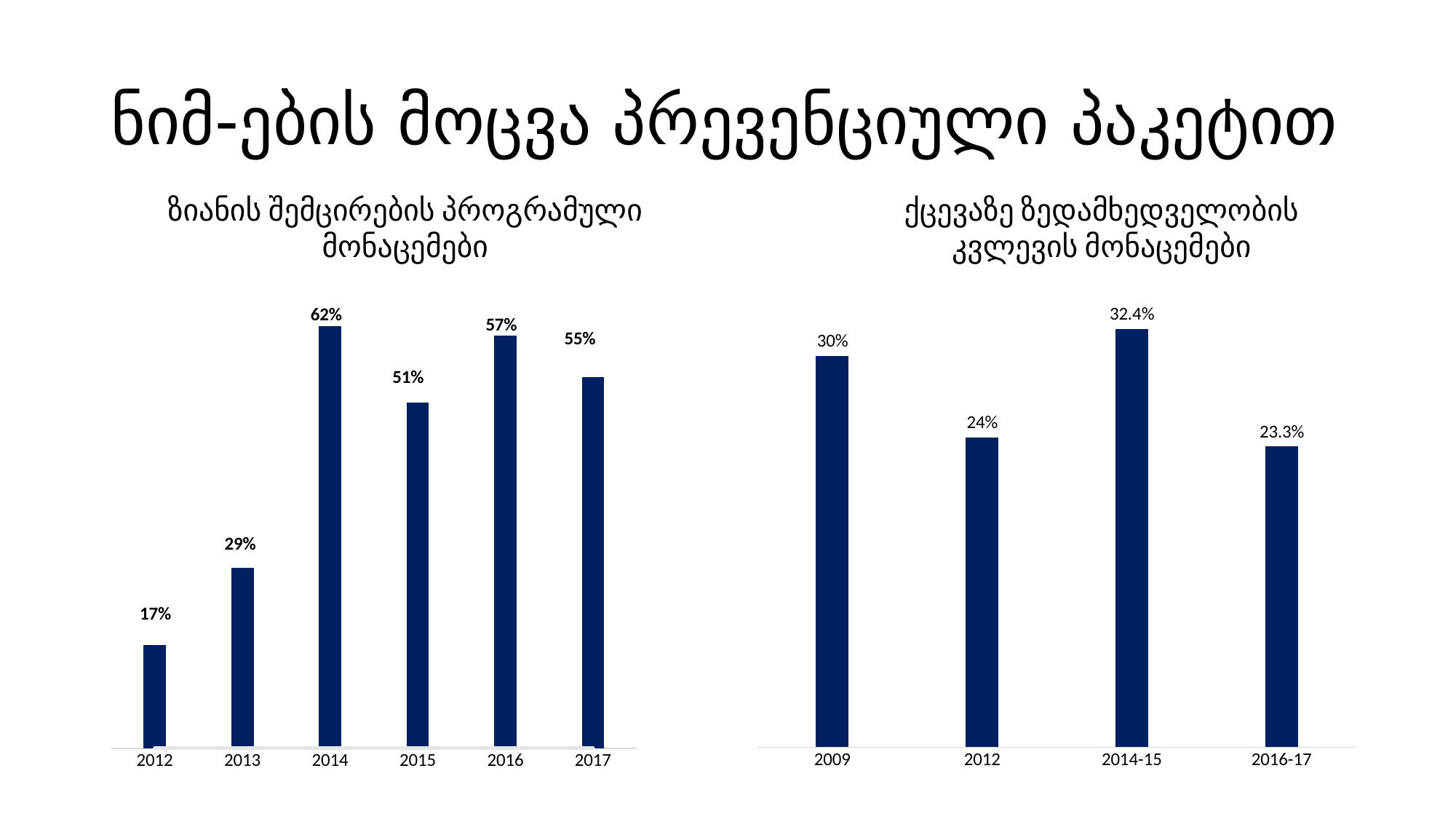
In the right chart, what is the value for 2016-17? 23.3% How many bars are in the right chart? 4 In the left chart, which is larger, the value for 2016 or the value for 2017? 2016 In the left chart, what is the difference between the values for 2014 and 2015? 11% In the left chart, what is the value for 2012? 17% In the right chart, what is the difference between the values for 2009 and 2012? 6% In the left chart, which year has the lowest value? 2012 In the left chart, what is the value for 2014? 62% In the right chart, which period has the lowest value? 2016-17 What type of chart is the left chart? Bar chart In the left chart, which year has the highest value? 2014 In the right chart, what is the value for 2014-15? 32.4%